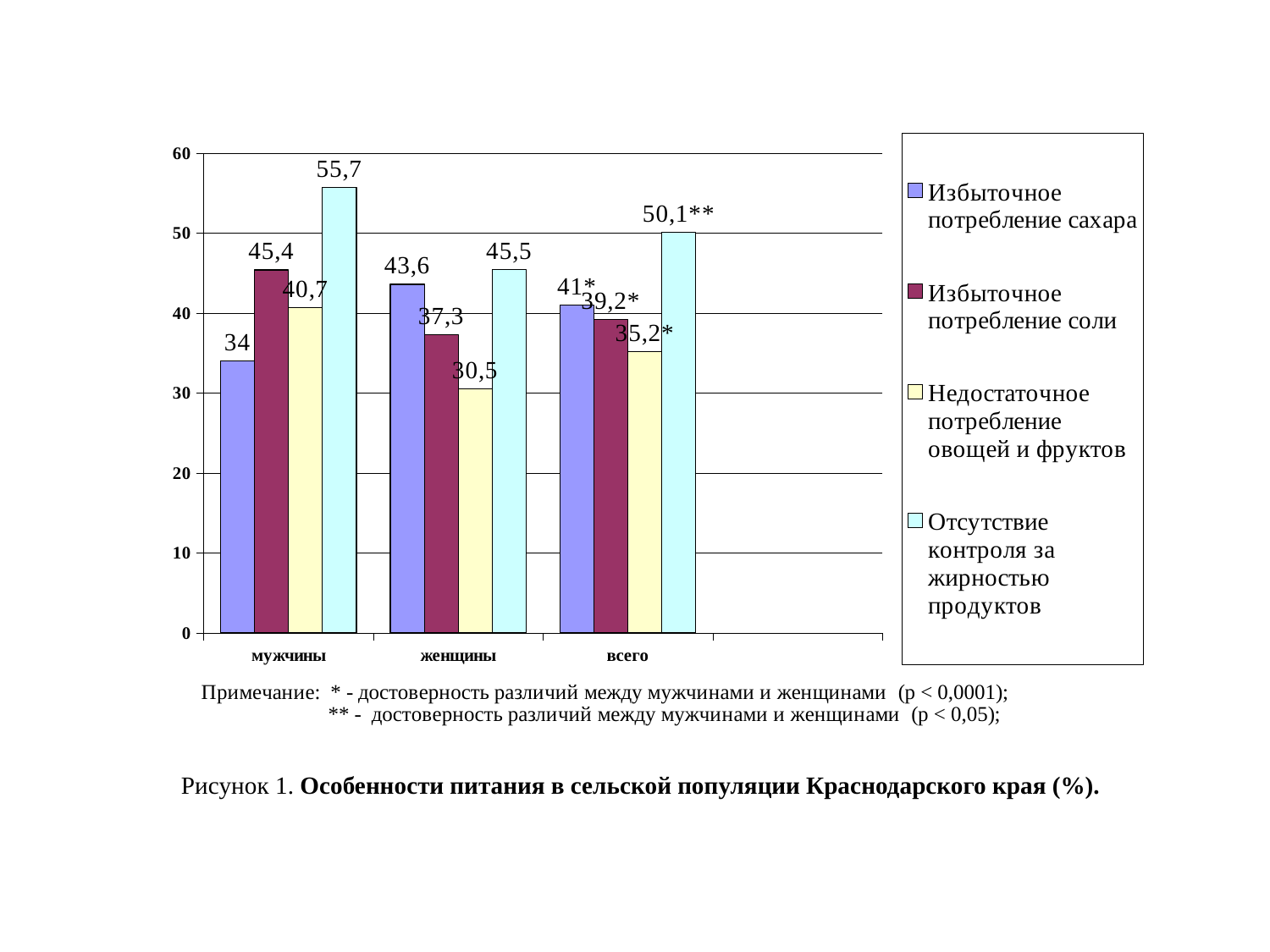
Is the value for 'Отсутствие контроля за жирностью продуктов' in the 'всего' category greater or less than 40? greater How many series does the legend list? 4 Which series has the lowest value in the 'женщины' category? Недостаточное потребление овощей и фруктов What is the value for 'Отсутствие контроля за жирностью продуктов' in the 'мужчины' category? 55,7 Which series has the highest value in the 'мужчины' category? Отсутствие контроля за жирностью продуктов What kind of chart is shown on the slide? bar chart What is the value for 'Недостаточное потребление овощей и фруктов' in the 'женщины' category? 30,5 Which is larger: 'Избыточное потребление сахара' for 'мужчины' or for 'женщины'? женщины What is the value for 'Избыточное потребление сахара' in the 'мужчины' category? 34 What is the value for 'Избыточное потребление соли' in the 'женщины' category? 37,3 What is the difference between 'Отсутствие контроля за жирностью продуктов' and 'Избыточное потребление сахара' in the 'мужчины' category? 21,7 How many categories are shown on the x axis? 3